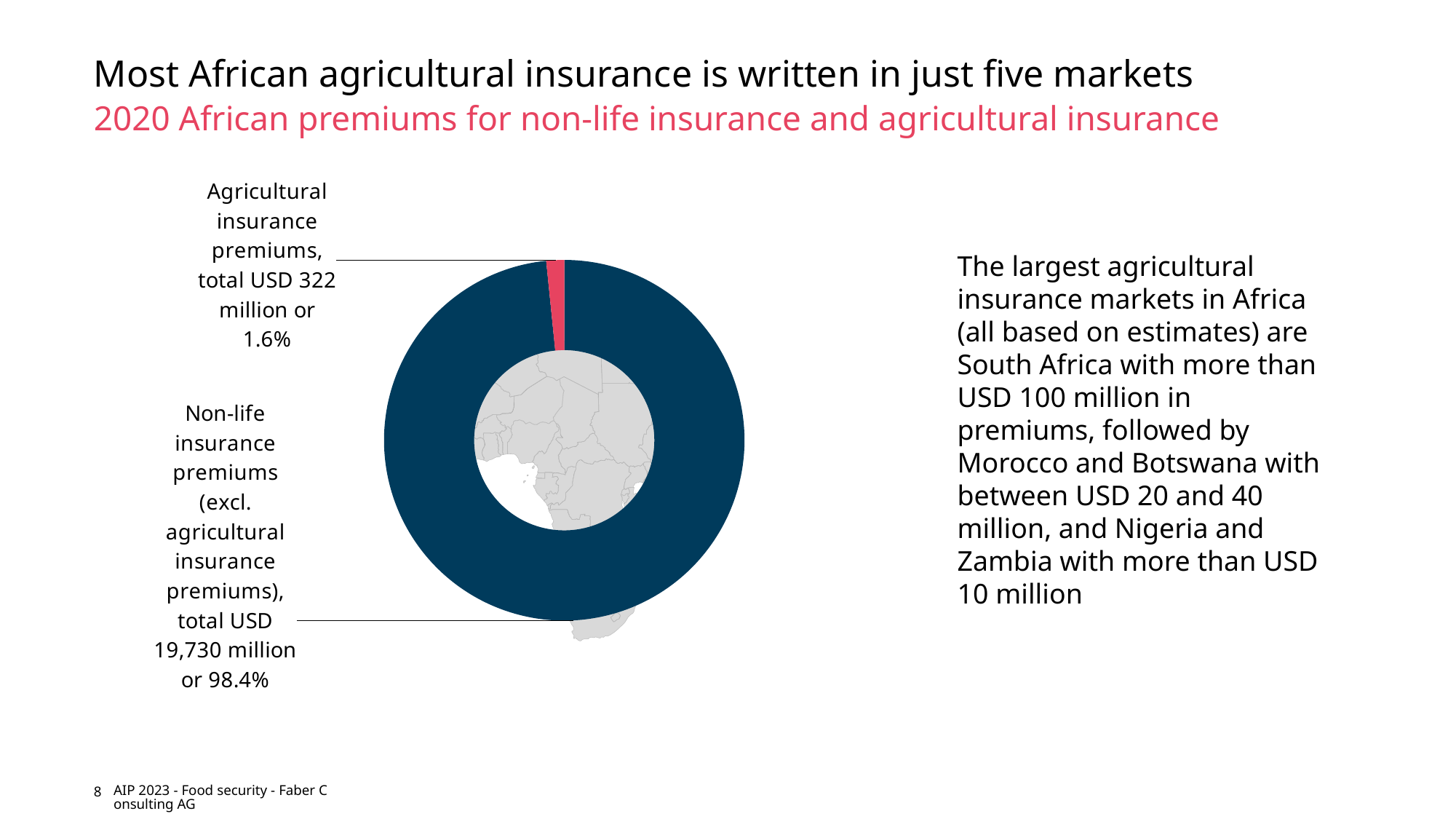
What is the total of non-life insurance premiums (excl. agricultural insurance premiums) shown in the chart? USD 19,730 million What is the difference in USD million between non-life insurance premiums and agricultural insurance premiums? 19,408 What is the subtitle of the chart on the slide? 2020 African premiums for non-life insurance and agricultural insurance What share of the chart do non-life insurance premiums (excl. agricultural insurance premiums) represent? 98.4% Which slice of the chart is the smallest? Agricultural insurance premiums What kind of chart is shown on the slide? Donut (pie) chart Which is larger: agricultural insurance premiums or non-life insurance premiums? Non-life insurance premiums What is the total of agricultural insurance premiums shown in the chart? USD 322 million What colour is the agricultural insurance premiums slice? Red (pink) Which slice of the chart is the largest? Non-life insurance premiums (excl. agricultural insurance premiums) How many slices does the donut chart have? 2 What share of the chart do agricultural insurance premiums represent? 1.6%